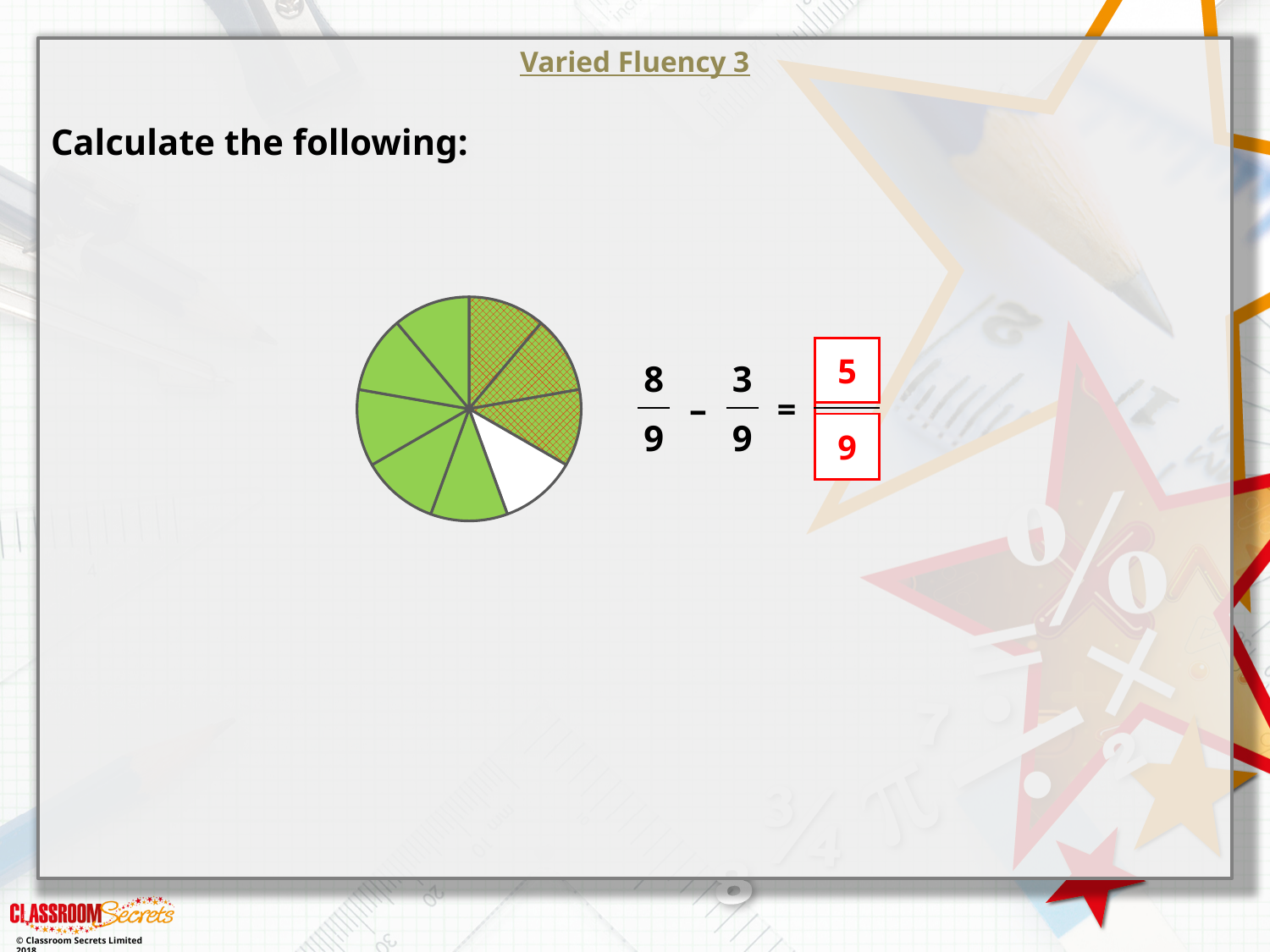
How many equal segments is the circle divided into? 9 How many segments of the circle are left white (unshaded)? 1 What fraction of the circle does a single segment represent? 1/9 Are there more plain green segments or cross-hatched segments in the circle? plain green What kind of chart is shown on the slide? pie chart What fraction of the circle is shown by the cross-hatched segments? 3/9 What is the title at the top of the slide? Varied Fluency 3 What is the answer to the calculation 8/9 − 3/9 shown next to the circle? 5/9 What fraction of the circle is shown by the plain green segments? 5/9 How many segments of the circle are shaded with the orange cross-hatch pattern? 3 What colour are the shaded segments of the circle? green